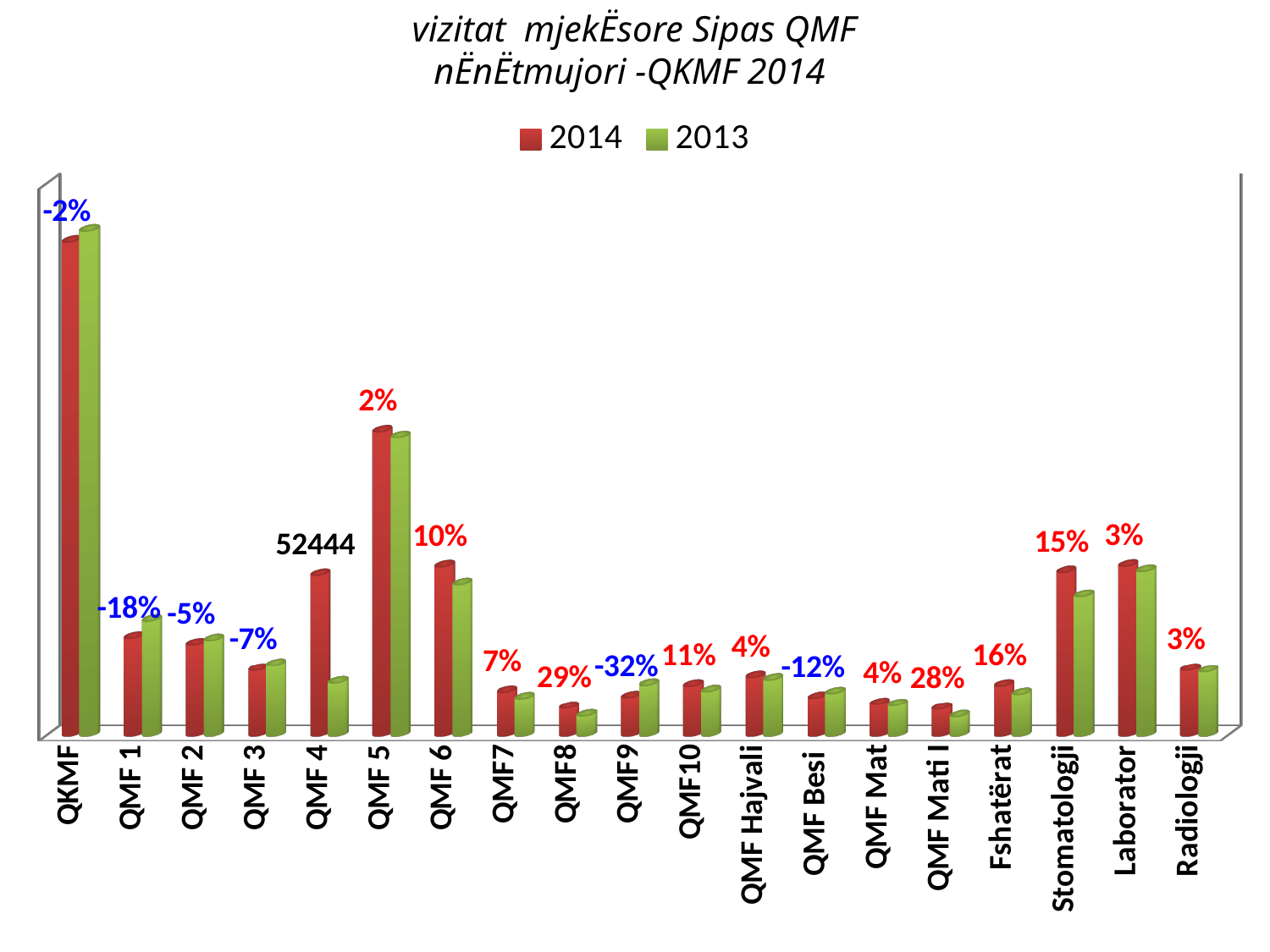
For QMF 1, which is larger, the 2014 bar or the 2013 bar? 2013 What percentage label is shown above QMF8? 29% For QMF 4, which is larger, the 2014 bar or the 2013 bar? 2014 Which category has the highest 2014 bar? QKMF Which colour represents the 2013 series in the legend? green What percentage label is shown above Stomatologji? 15% How many categories are shown on the x axis? 19 What kind of chart is shown on the slide? bar chart How many series does the legend list? 2 What percentage label is shown above QMF9? -32% Which category has the highest 2013 bar? QKMF What value is labelled on the 2014 bar for QMF 4? 52444